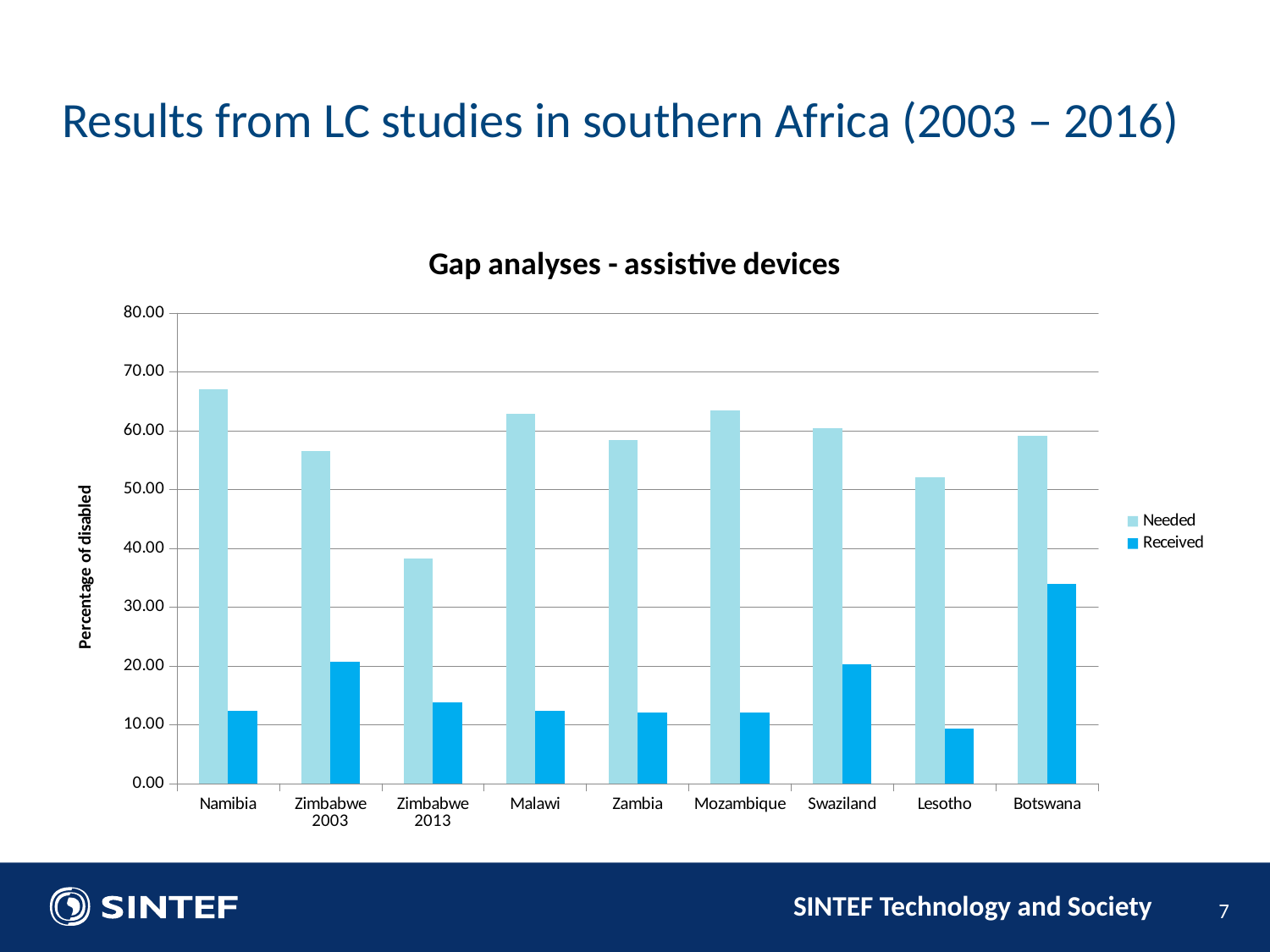
Which is larger, the Needed value for Zimbabwe 2003 or the Needed value for Zimbabwe 2013? Zimbabwe 2003 Is the Needed value for Malawi greater or less than 60.00? greater Is the Needed value for Zimbabwe 2013 greater or less than 40.00? less Which category has the highest Received value? Botswana What is the title of the chart? Gap analyses - assistive devices Is the Received value for Botswana greater or less than 30.00? greater How many categories are shown on the x axis? 9 What type of chart is shown on the slide? bar chart Which category has the highest Needed value? Namibia Which category has the lowest Needed value? Zimbabwe 2013 How many series does the legend list? 2 Which category has the lowest Received value? Lesotho